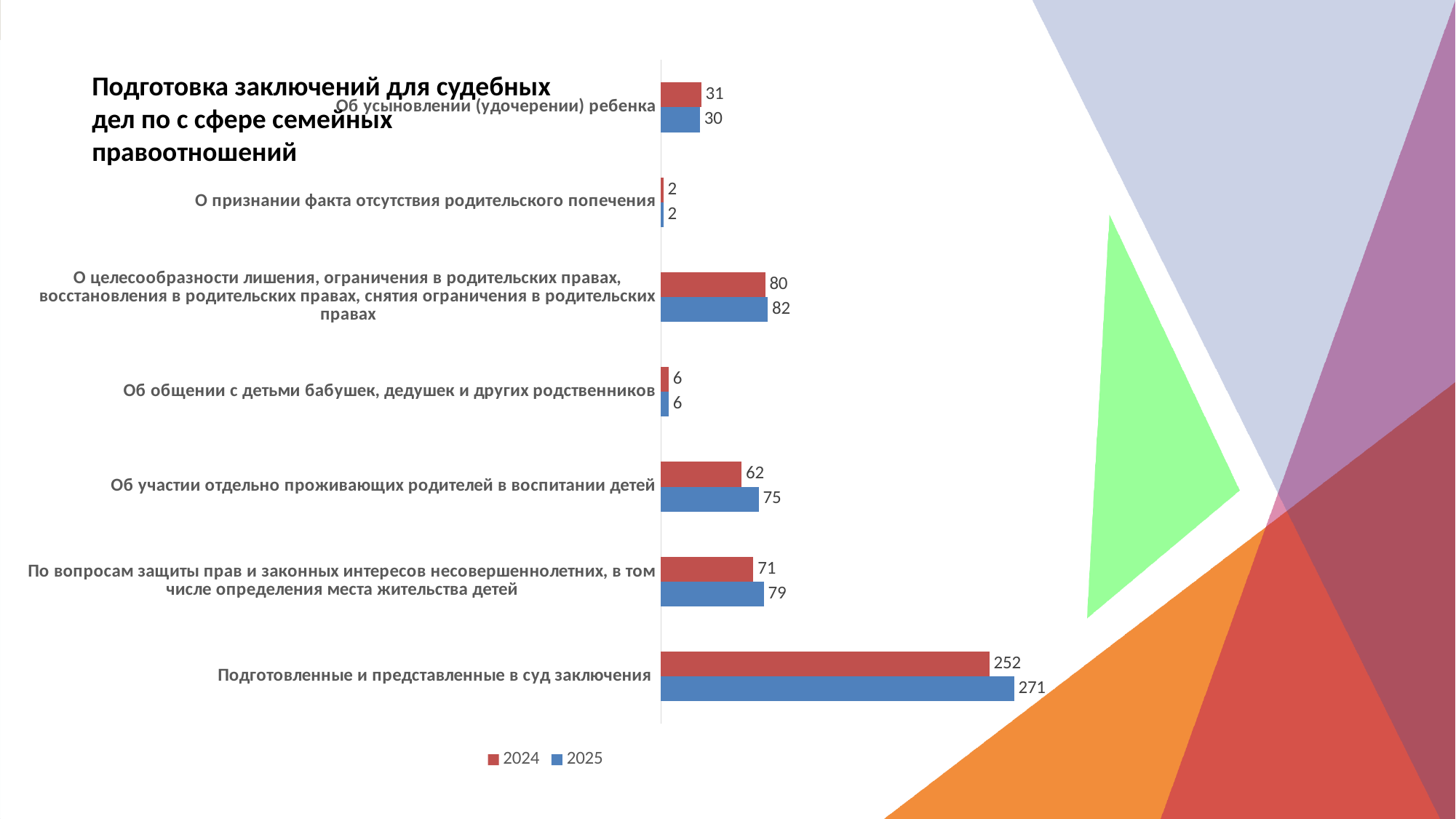
What is the difference between the 2025 and 2024 values for «Об участии отдельно проживающих родителей в воспитании детей»? 13 Which category has the highest 2025 value? Подготовленные и представленные в суд заключения What is the 2025 value for «Об участии отдельно проживающих родителей в воспитании детей»? 75 What is the 2024 value for «По вопросам защиты прав и законных интересов несовершеннолетних, в том числе определения места жительства детей»? 71 How many series does the legend list? 2 What is the difference between the 2025 and 2024 values for «Подготовленные и представленные в суд заключения»? 19 What is the 2025 value for «Подготовленные и представленные в суд заключения»? 271 What is the 2024 value for «Об усыновлении (удочерении) ребенка»? 31 Which category has the lowest 2024 value? О признании факта отсутствия родительского попечения What kind of chart is shown on the slide? Bar chart How many categories are shown in the chart? 7 For «Об усыновлении (удочерении) ребенка», which year has the larger value, 2024 or 2025? 2024